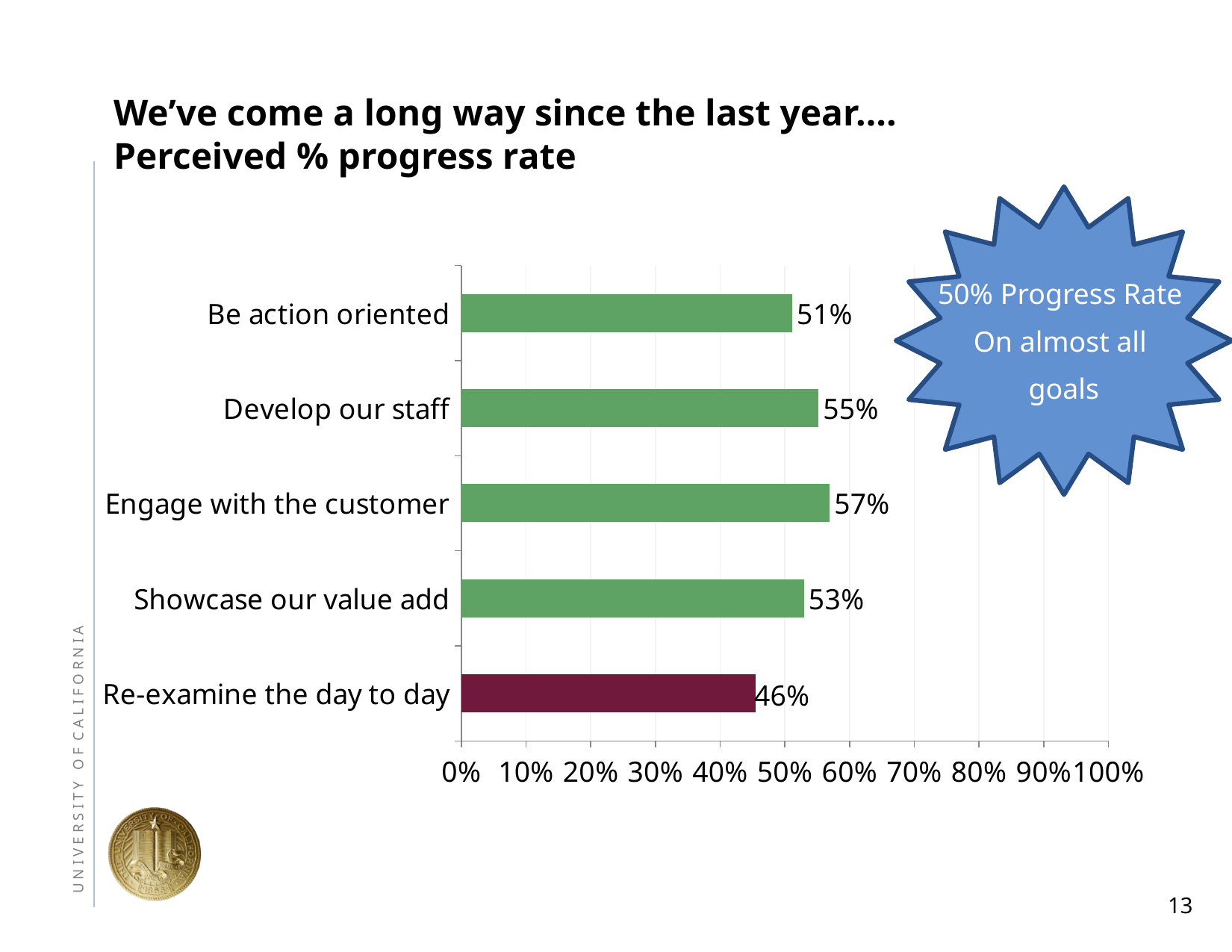
Which goal has the highest perceived progress rate? Engage with the customer What is the perceived progress rate for Re-examine the day to day? 46% What is the difference between the progress rates for Develop our staff and Be action oriented? 4% What is the perceived progress rate for Engage with the customer? 57% Is the value for Re-examine the day to day greater or less than 50%? less How many goals are shown in the chart? 5 What kind of chart is shown on the slide? Bar chart Which goal has the lowest perceived progress rate? Re-examine the day to day What is the perceived progress rate for Develop our staff? 55% Which bar is coloured differently from the others? Re-examine the day to day What is the difference between the progress rates for Engage with the customer and Re-examine the day to day? 11% Which has a higher progress rate, Showcase our value add or Be action oriented? Showcase our value add